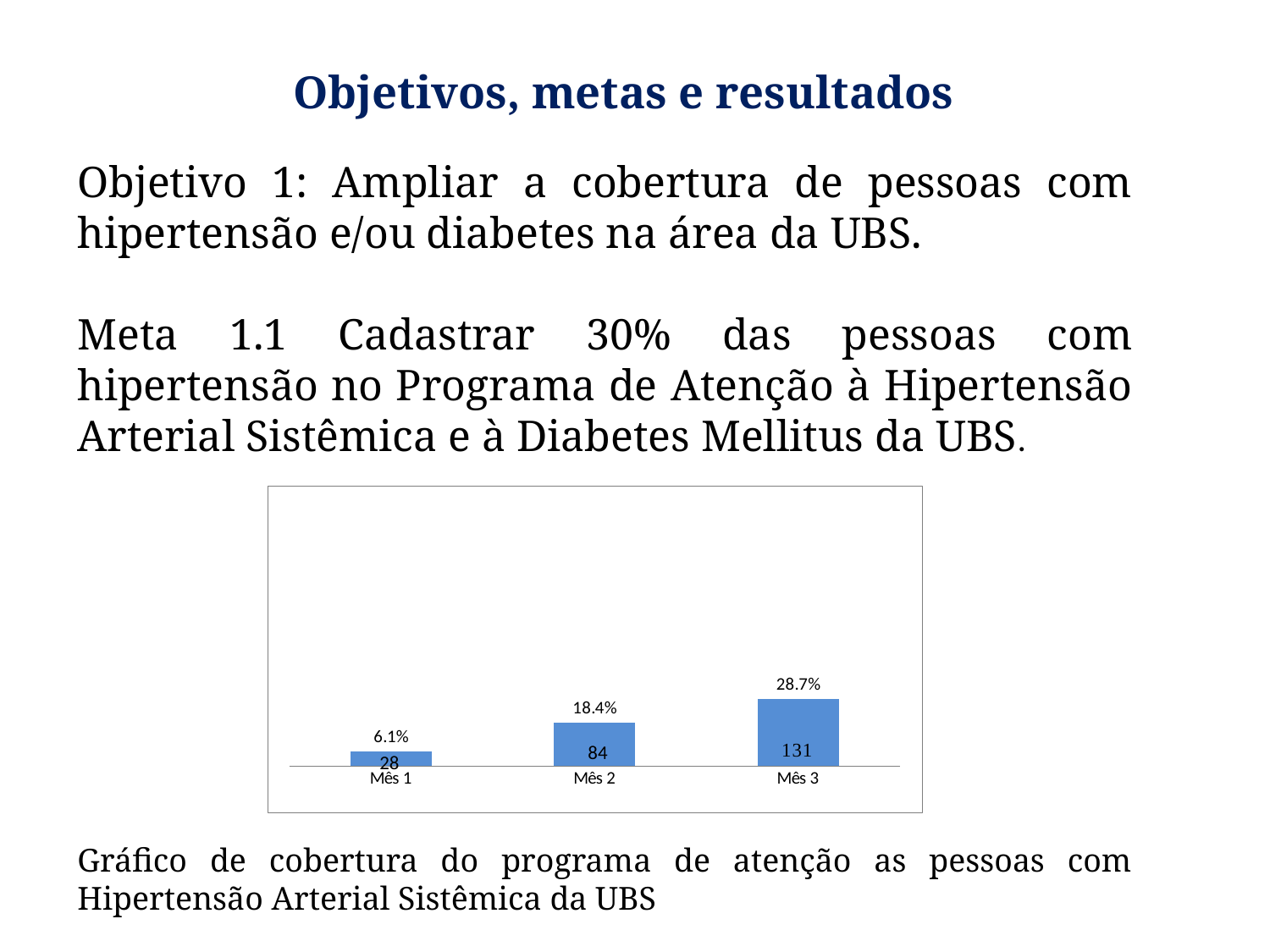
What percentage is shown for Mês 1? 6.1% Do the values rise or fall from Mês 1 to Mês 3? rise What number of people is shown for Mês 3? 131 Which is larger, the value for Mês 2 or the value for Mês 1? Mês 2 How many categories (months) are plotted in the chart? 3 What is the difference in percentage points between Mês 3 and Mês 1? 22.6 Which month has the lowest value in the chart? Mês 1 What number of people is shown inside the bar for Mês 2? 84 Which month has the highest value in the chart? Mês 3 What percentage is shown for Mês 2? 18.4% What kind of chart is shown on the slide? bar chart What percentage is shown for Mês 3? 28.7%